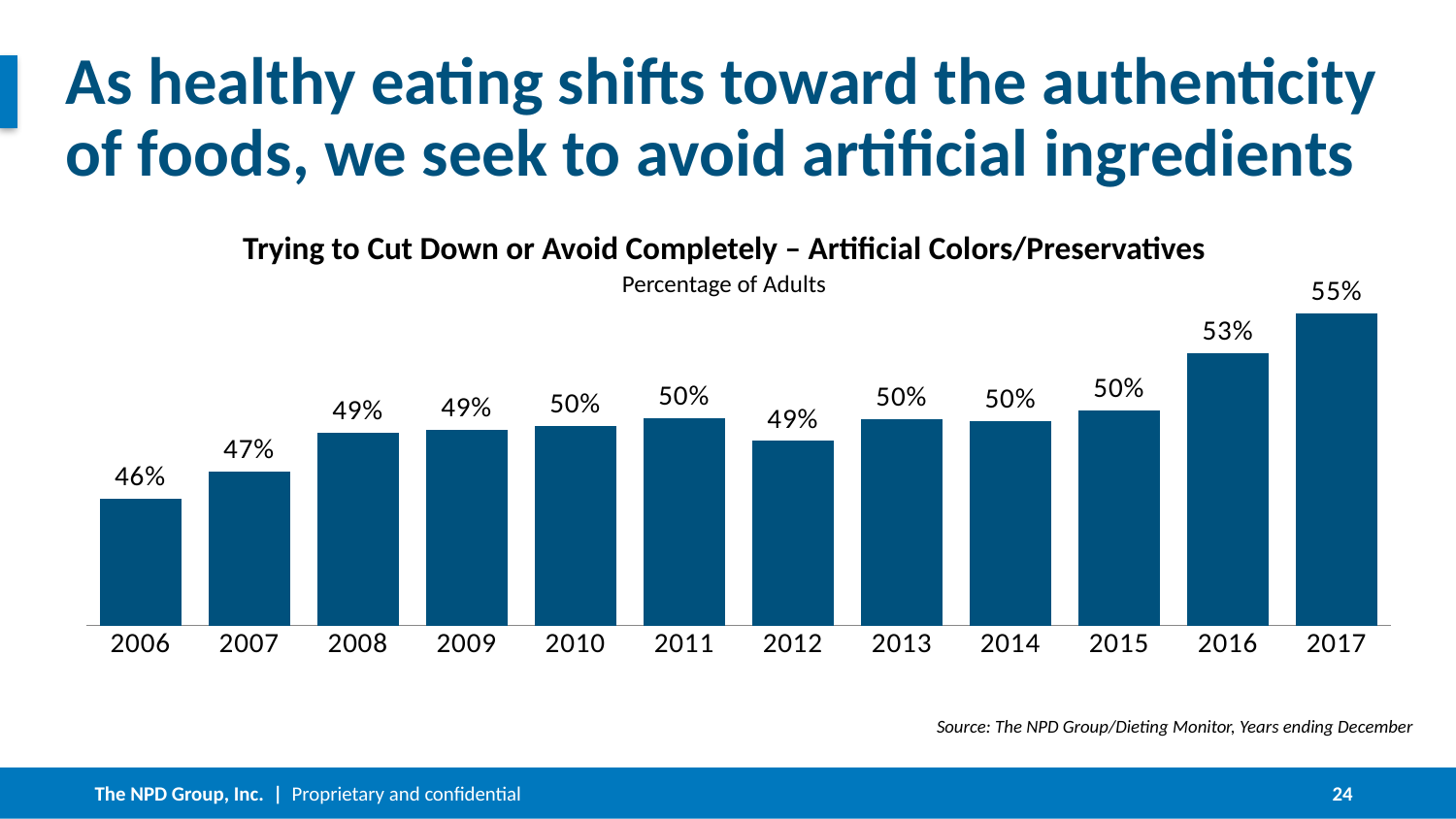
How many years are shown on the x axis? 12 Overall, do the values rise or fall from 2006 to 2017? Rise Which year has the highest percentage of adults? 2017 Which year has the lowest percentage of adults? 2006 What kind of chart is shown on the slide? Bar chart What is the difference between the 2017 value and the 2006 value? 9% Which is larger, the value for 2012 or the value for 2013? 2013 What is the difference between the 2016 value and the 2015 value? 3% What percentage of adults were trying to cut down on or avoid artificial colors/preservatives in 2006? 46% What is the value shown for 2016? 53% What is the title of the chart? Trying to Cut Down or Avoid Completely – Artificial Colors/Preservatives What is the value shown for 2012? 49%